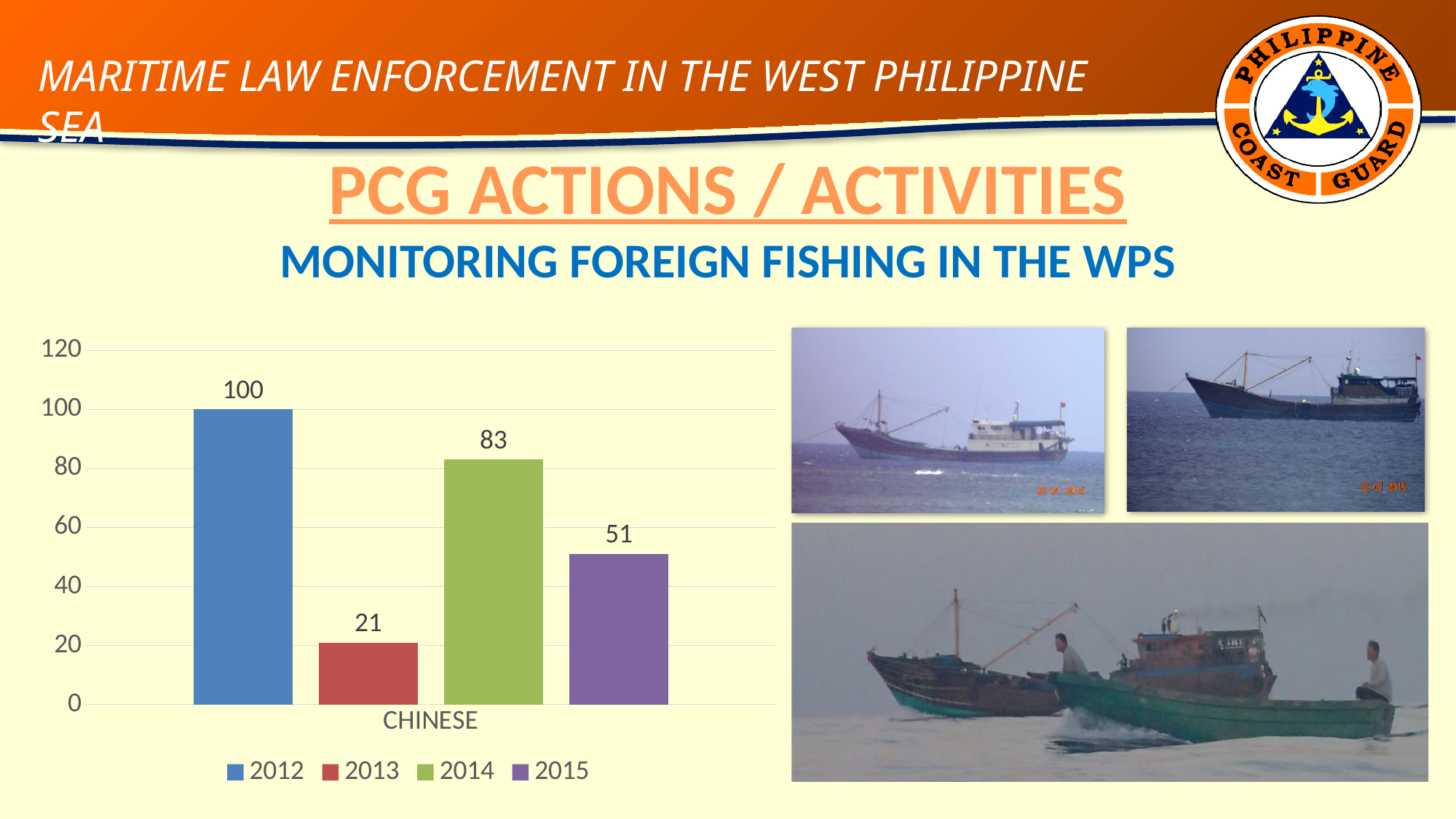
What is the value for 2014 in the chart? 83 Which year has the highest value in the chart? 2012 Which year has the lowest value in the chart? 2013 What is the value for 2015 in the chart? 51 Which is larger, the value for 2014 or the value for 2015? 2014 What is the value for 2013 in the chart? 21 What is the difference between the values for 2012 and 2013? 79 What kind of chart is shown on the slide? Bar chart What is the category label shown on the x axis of the chart? CHINESE How many series does the legend list? 4 What is the difference between the values for 2014 and 2015? 32 What is the value for 2012 in the chart? 100